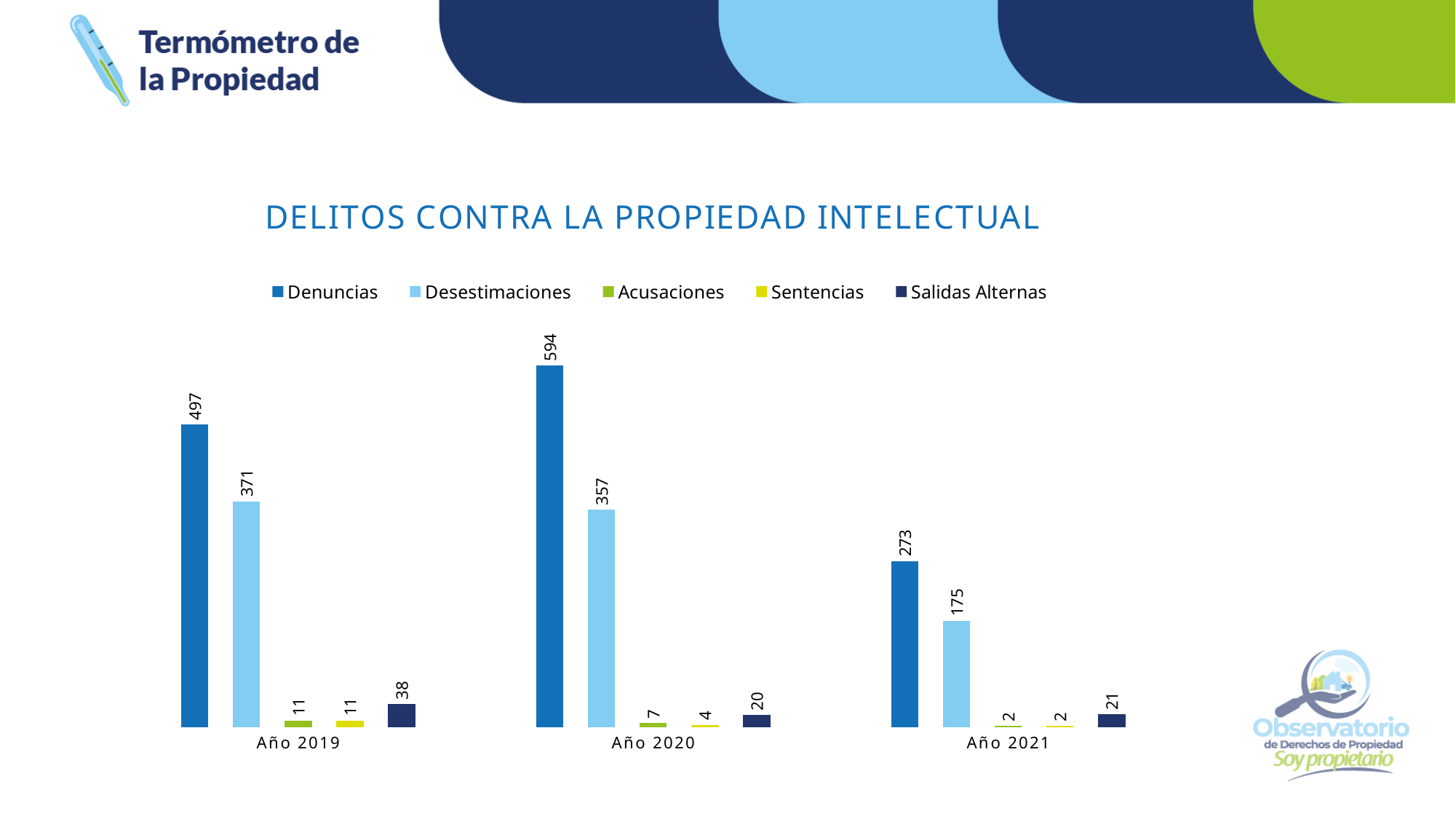
What is the difference between Denuncias in Año 2020 and Año 2019? 97 In which year is the Denuncias value highest? Año 2020 What is the value of Salidas Alternas for Año 2021? 21 How many years (categories) are shown on the x axis? 3 What is the title of the chart? DELITOS CONTRA LA PROPIEDAD INTELECTUAL How many series does the legend list? 5 What kind of chart is shown on the slide? Bar chart In which year is the Desestimaciones value lowest? Año 2021 What is the value of Denuncias for Año 2020? 594 What is the value of Sentencias for Año 2020? 4 Which is larger: Salidas Alternas in Año 2019 or in Año 2020? Año 2019 What is the value of Desestimaciones for Año 2019? 371